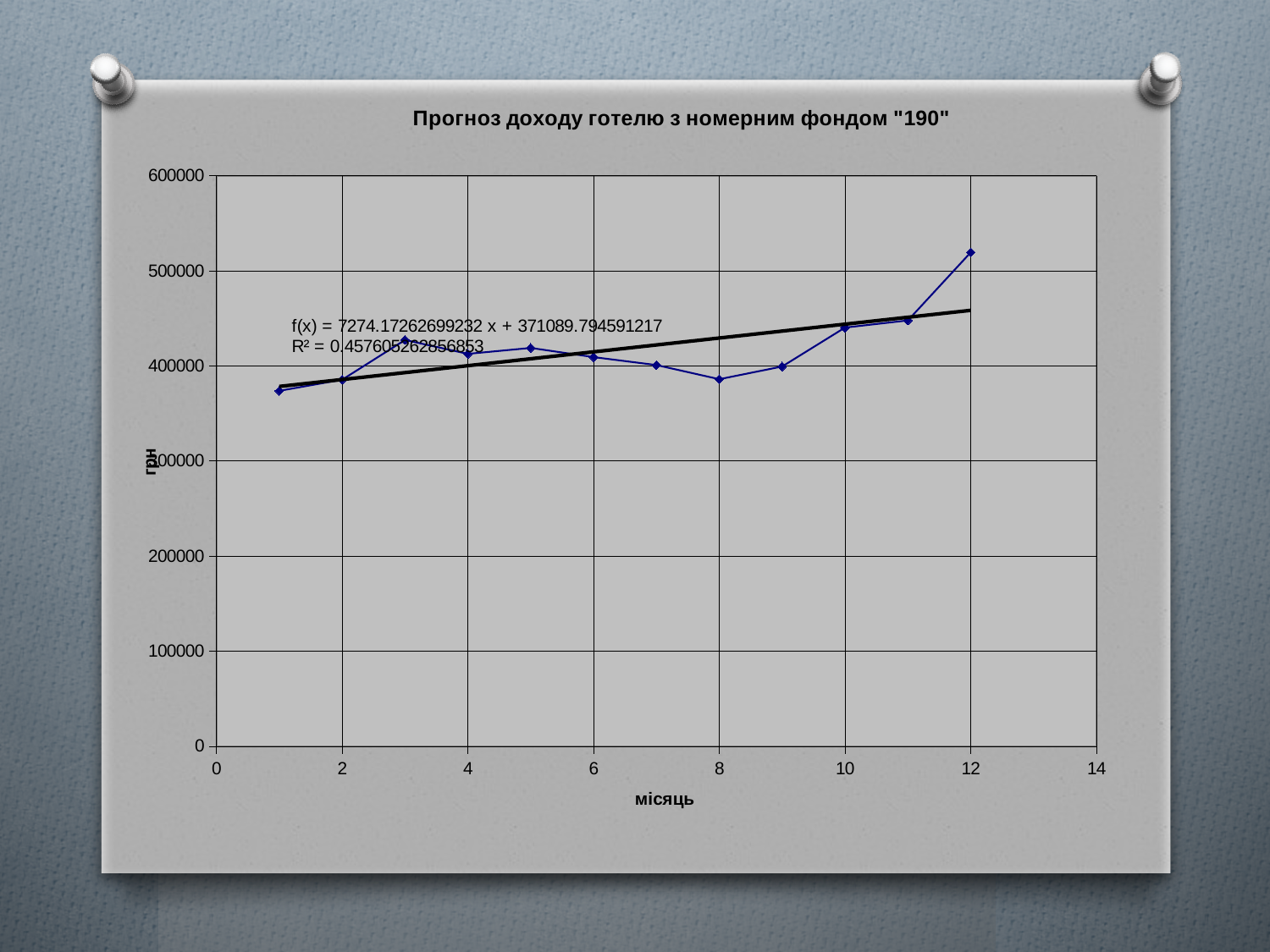
Which has the larger value, month 12 or month 1? month 12 Is the value for month 12 greater or less than 500000? greater At which month is the plotted value highest? 12 What is the title of the chart? Прогноз доходу готелю з номерним фондом "190" What is the label of the x axis? місяць What kind of chart is shown on the slide? line chart How many data points are plotted on the line? 12 Do the values generally rise or fall from month 1 to month 12? rise Is the value for month 3 greater or less than 400000? greater Which has the larger value, month 3 or month 8? month 3 Is the value for month 8 greater or less than 400000? less